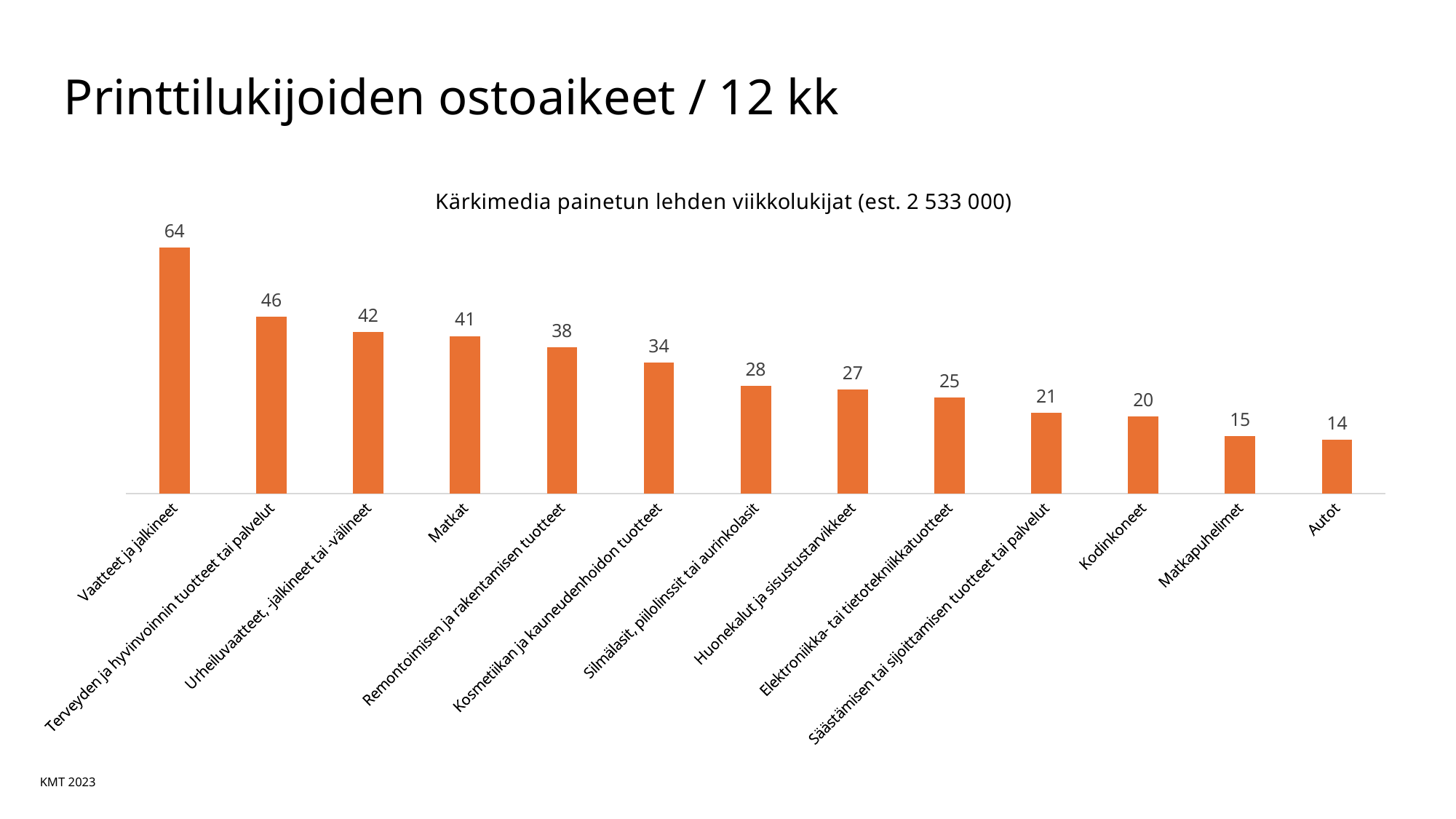
How many categories are shown in the chart? 13 Which category has the lowest value? Autot What is the difference between the values for Vaatteet ja jalkineet and Autot? 50 What kind of chart is shown on the slide? Bar chart What is the title of the chart? Kärkimedia painetun lehden viikkolukijat (est. 2 533 000) What is the value for Matkat? 41 What is the value for Silmälasit, piilolinssit tai aurinkolasit? 28 What is the value for Kodinkoneet? 20 Do the values rise or fall from left to right along the x axis? Fall Which category has the highest value? Vaatteet ja jalkineet What is the difference between the values for Terveyden ja hyvinvoinnin tuotteet tai palvelut and Matkapuhelimet? 31 Which is larger, the value for Kosmetiikan ja kauneudenhoidon tuotteet or the value for Huonekalut ja sisustustarvikkeet? Kosmetiikan ja kauneudenhoidon tuotteet